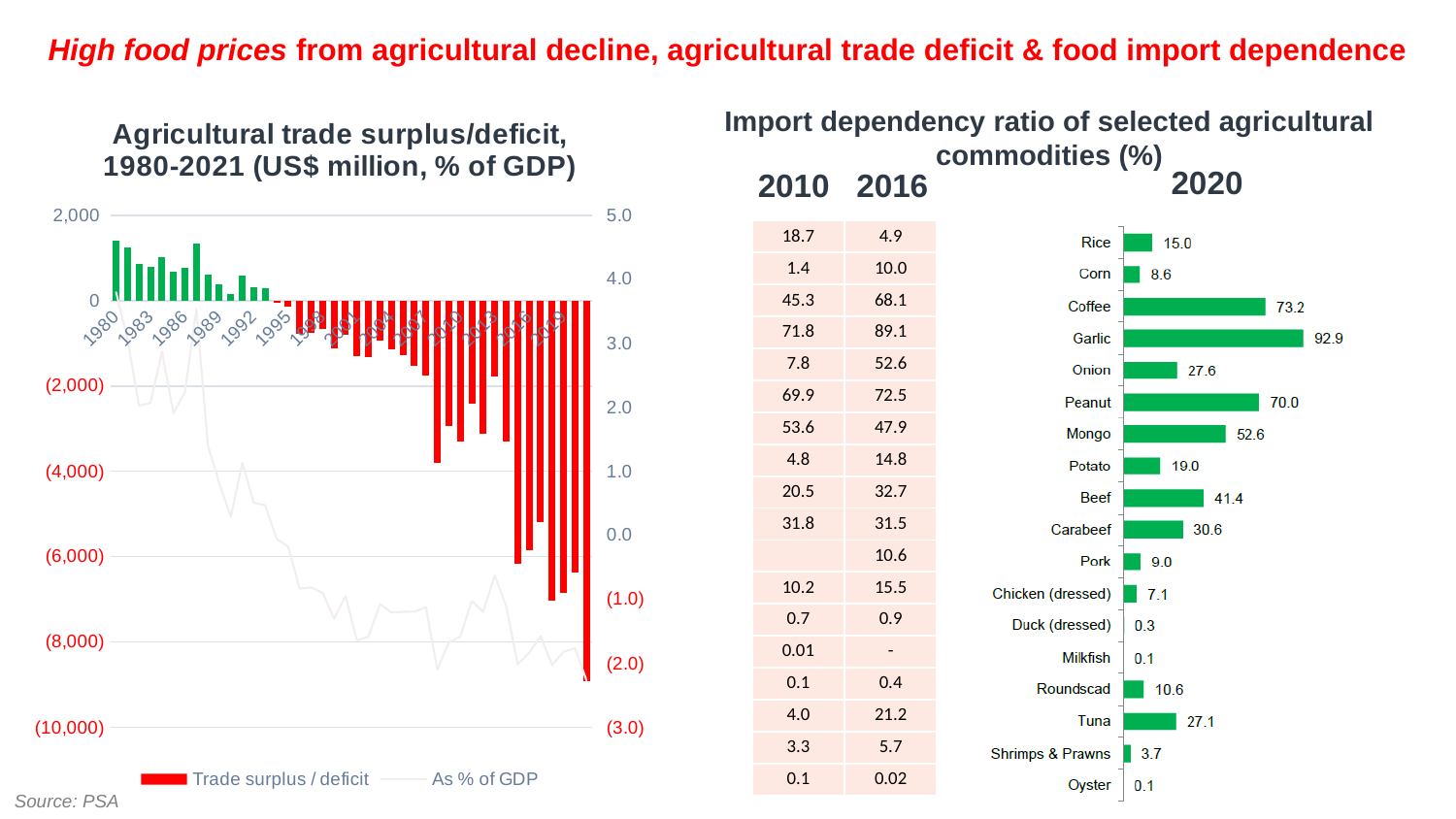
In the 'Import dependency ratio of selected agricultural commodities (%)' chart, what is the 2020 value for Tuna? 27.1 In the 'Import dependency ratio of selected agricultural commodities (%)' chart, which commodity has the highest 2020 value? Garlic What kind of chart is the 'Import dependency ratio of selected agricultural commodities (%)' chart for 2020? Bar chart How many series does the legend of the 'Agricultural trade surplus/deficit, 1980-2021' chart list? 2 In the 'Import dependency ratio of selected agricultural commodities (%)' chart, what is the 2020 value for Rice? 15.0 In the 'Agricultural trade surplus/deficit, 1980-2021' chart, do the trade surplus/deficit bars generally rise or fall from 1980 to 2021? Fall In the 'Import dependency ratio of selected agricultural commodities (%)' chart, what is the 2020 value for Beef? 41.4 In the 'Import dependency ratio of selected agricultural commodities (%)' chart, how many commodities are plotted for 2020? 18 In the 'Agricultural trade surplus/deficit, 1980-2021' chart, what colour are the bars for the deficit years? Red In the 'Import dependency ratio of selected agricultural commodities (%)' chart, what is the 2020 value for Garlic? 92.9 In the 'Import dependency ratio of selected agricultural commodities (%)' chart, which has a higher 2020 value, Peanut or Mongo? Peanut In the 'Import dependency ratio of selected agricultural commodities (%)' chart, what is the difference between the 2020 values for Garlic and Coffee? 19.7